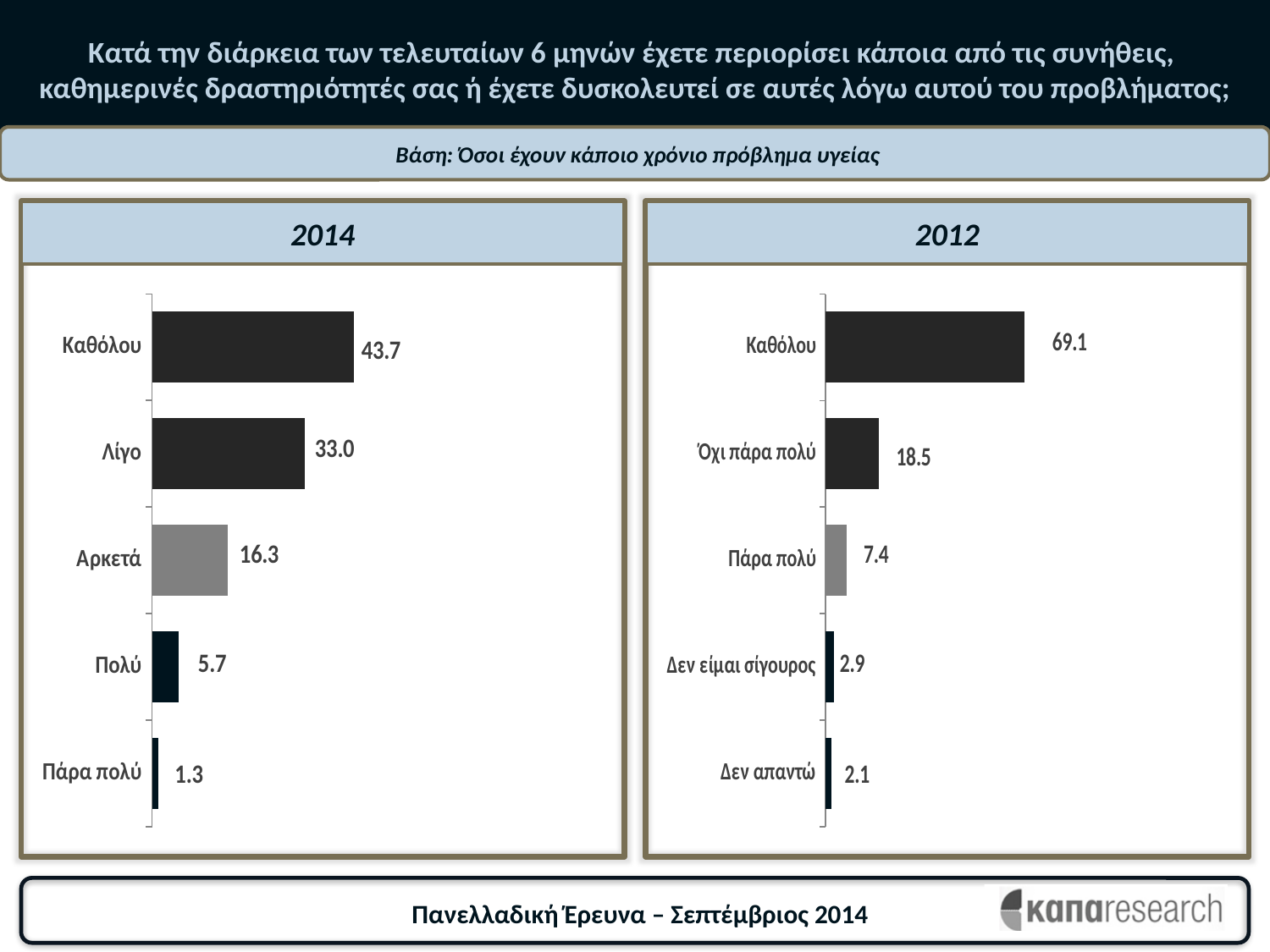
In the 2014 chart, which category has the lowest value? Πάρα πολύ In the 2014 chart, what is the value for Αρκετά? 16.3 Which is larger: Καθόλου in the 2014 chart or Καθόλου in the 2012 chart? Καθόλου in the 2012 chart In the 2012 chart, which category has the highest value? Καθόλου In the 2014 chart, what is the value for Πολύ? 5.7 What kind of chart is the 2012 chart? bar chart In the 2014 chart, what is the difference between Καθόλου and Λίγο? 10.7 In the 2012 chart, which category has the lowest value? Δεν απαντώ In the 2014 chart, what is the value for Καθόλου? 43.7 In the 2012 chart, what is the value for Όχι πάρα πολύ? 18.5 How many categories are shown in the 2014 chart? 5 In the 2012 chart, what is the difference between Καθόλου and Όχι πάρα πολύ? 50.6